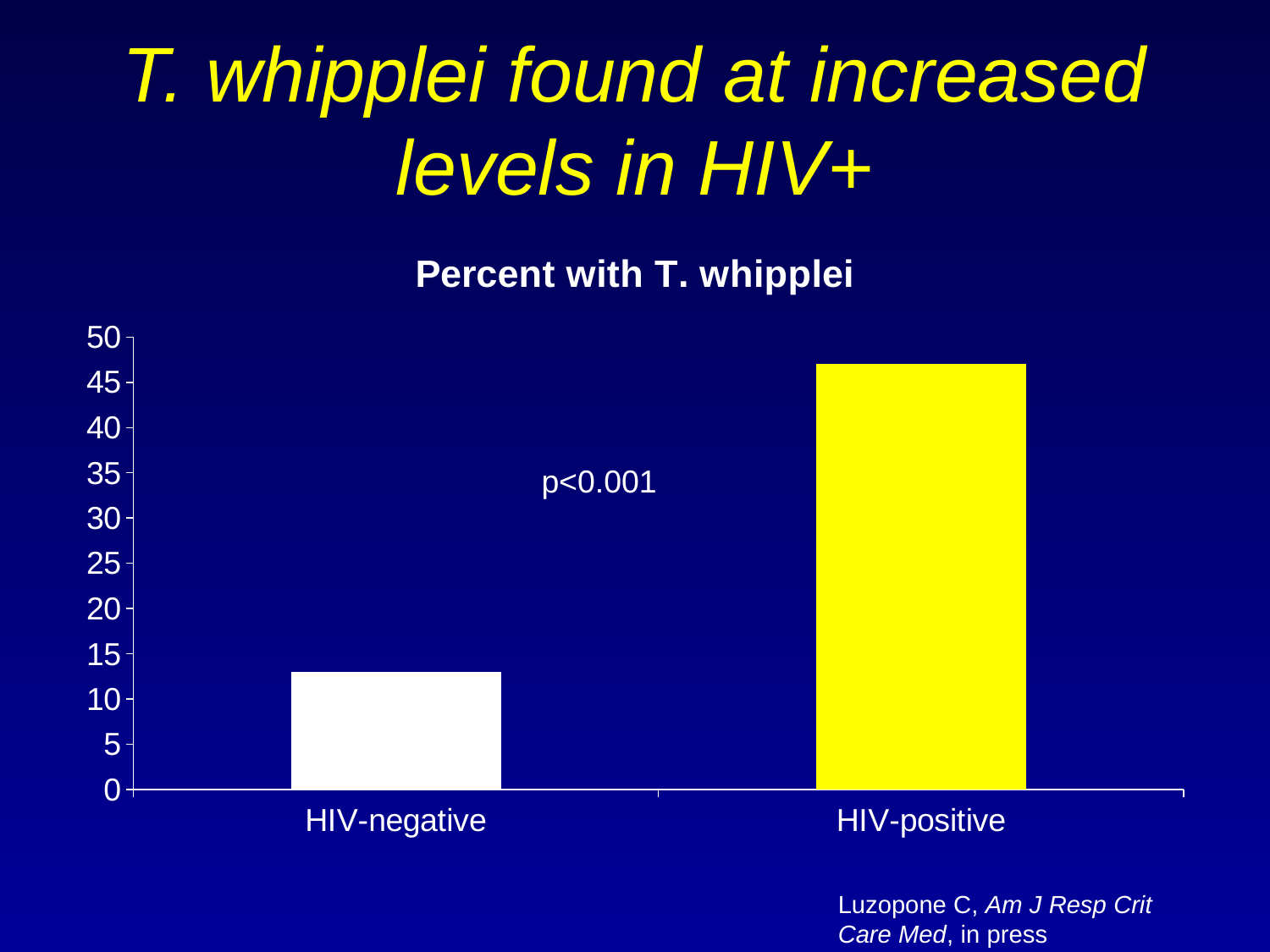
Is the value for HIV-negative greater or less than 10? greater What is the title of the chart? Percent with T. whipplei Is the value for HIV-positive greater or less than 50? less How many categories are plotted on the chart? 2 Which category has the lower percent with T. whipplei? HIV-negative What p-value is shown on the chart? p<0.001 Is the value for HIV-positive greater or less than 45? greater Is the value for HIV-positive larger or smaller than the value for HIV-negative? larger What kind of chart is shown on the slide? bar chart Which category has the higher percent with T. whipplei? HIV-positive